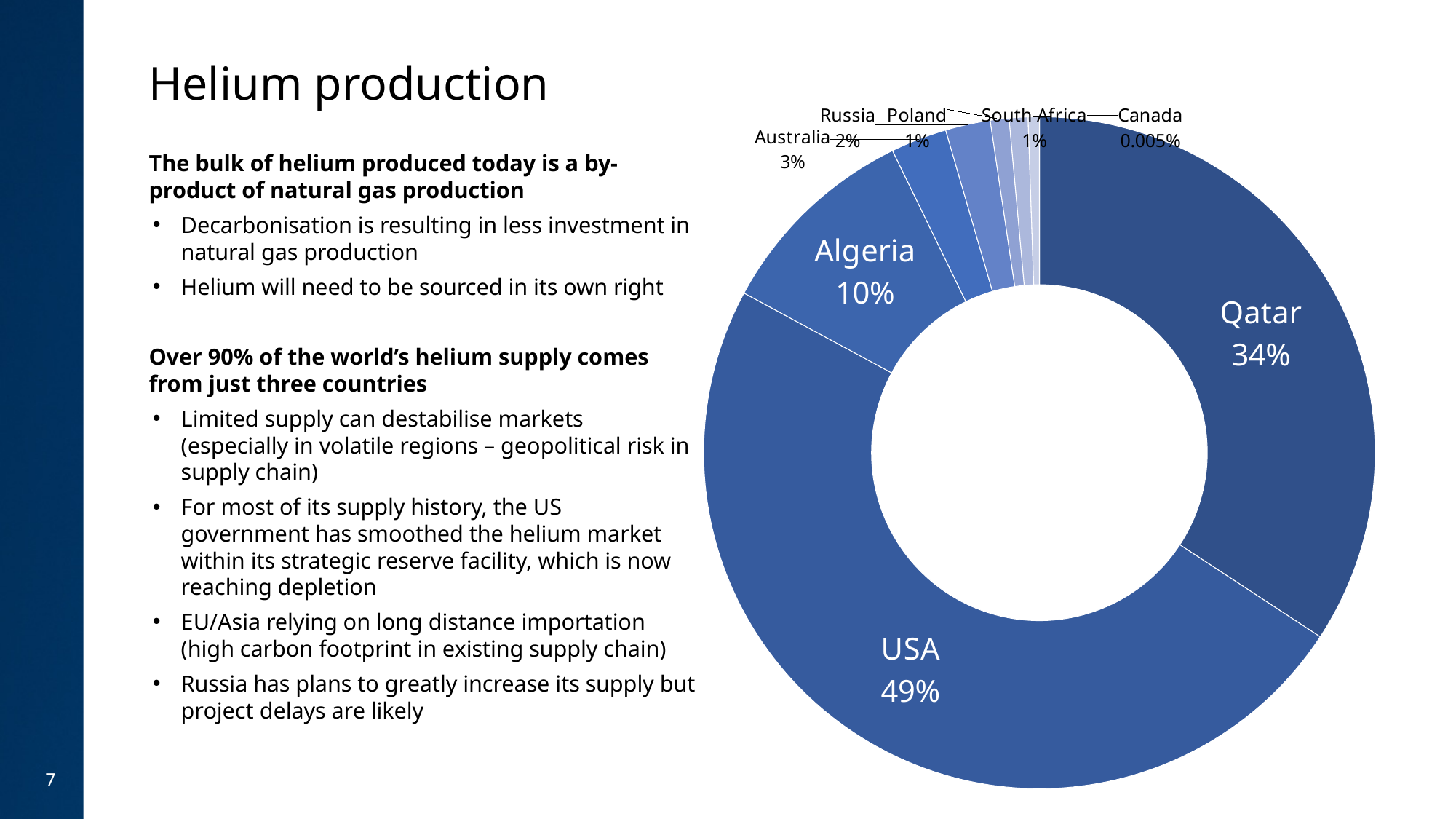
What is the value shown for Australia? 3% What is the value shown for Qatar? 34% What is the value shown for Russia? 2% What share of helium production does the USA account for? 49% What is the difference in percentage points between the USA's share and Qatar's share? 15 percentage points Which country has the largest share of helium production? USA Which country has the smallest share of helium production? Canada Which has a larger share, Qatar or Algeria? Qatar What is the value shown for Algeria? 10% What is the value shown for Canada? 0.005% How many countries are shown in the chart? 8 What kind of chart is shown on the slide? Doughnut (pie) chart